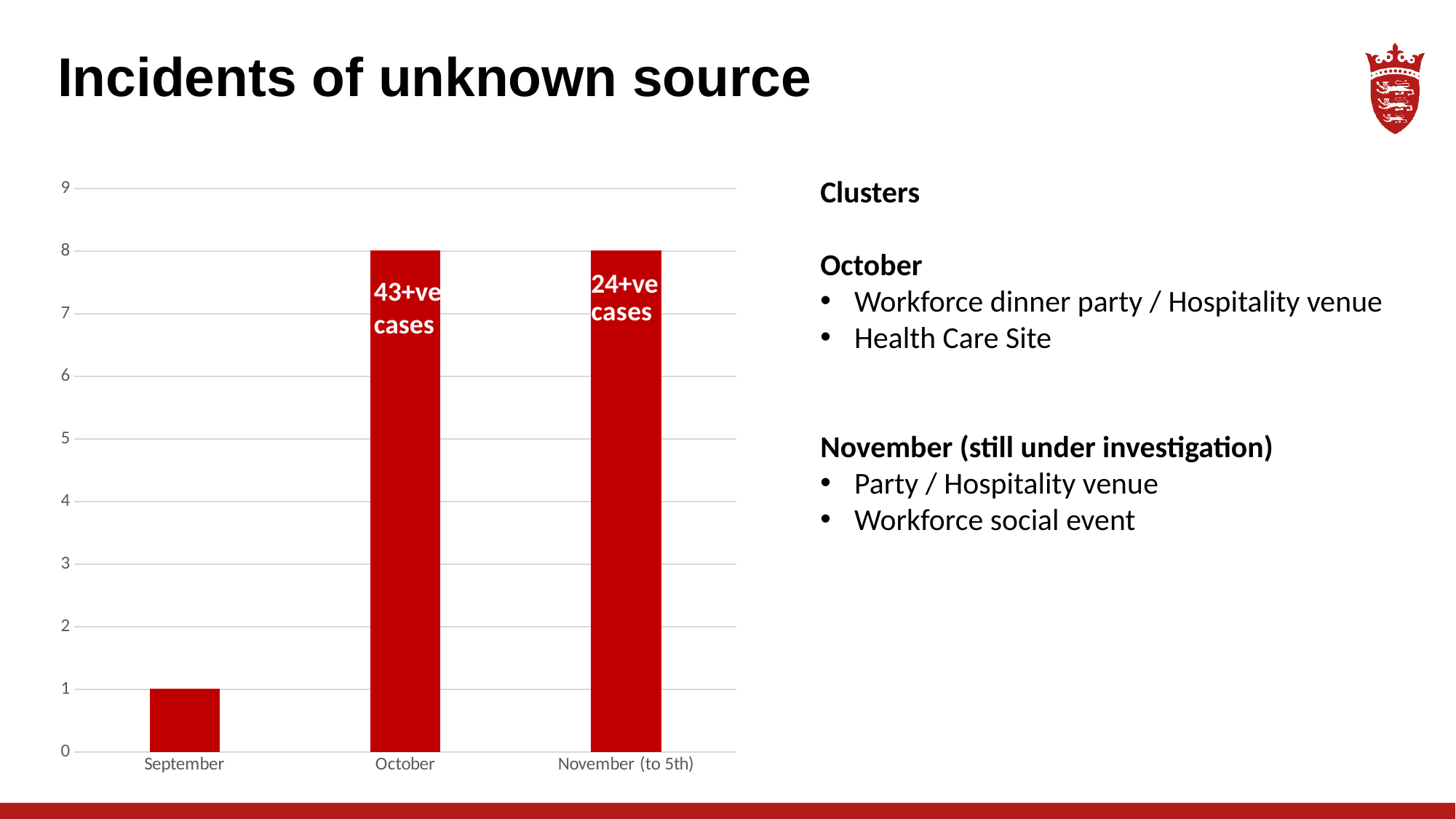
Is the value for September greater or less than 5? less What kind of chart is shown on the slide? bar chart What is the difference between the values for October and September? 7 What label is printed on the November (to 5th) bar? 24+ve cases What is the value for November (to 5th)? 8 What is the value for October? 8 What label is printed on the October bar? 43+ve cases Is the value for November (to 5th) greater or less than 5? greater How many months are shown on the x axis? 3 Which is larger, the value for September or the value for October? October Which month has the lowest value? September What is the value for September? 1